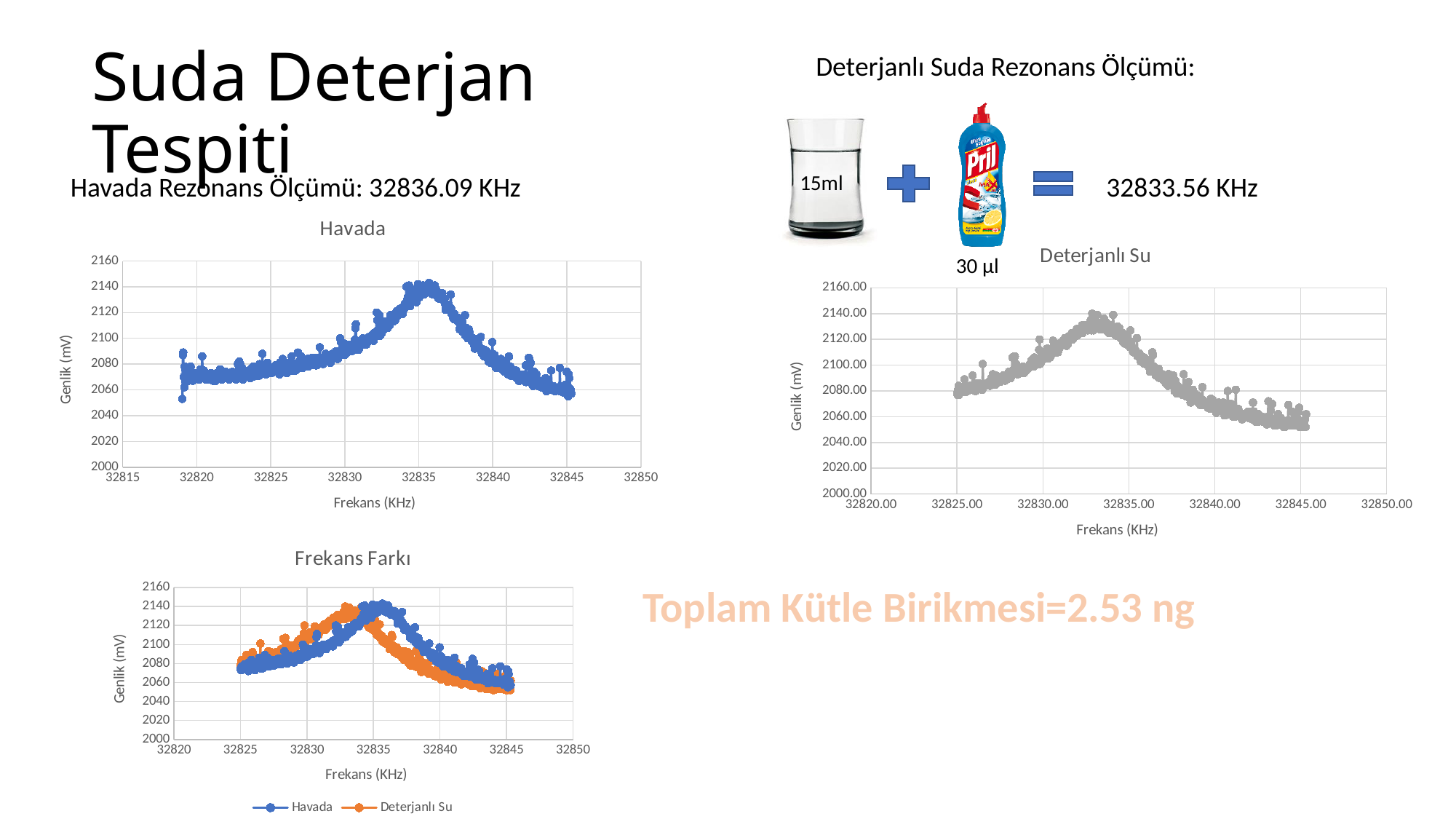
In the "Frekans Farkı" chart, how many series does the legend list? 2 How many charts are shown on the slide? 3 In the "Frekans Farkı" chart, which series reaches its peak at a higher frequency, "Havada" or "Deterjanlı Su"? Havada In the "Frekans Farkı" chart, what are the two series named in the legend? Havada and Deterjanlı Su In the "Deterjanlı Su" chart, is the peak amplitude value greater or less than 2120.00? greater What kind of chart is the "Havada" chart? scatter chart In the "Deterjanlı Su" chart, is the value at 32825.00 KHz greater or less than 2100.00? less In the "Havada" chart, do the values rise or fall between 32835 and 32845 KHz? fall In the "Frekans Farkı" chart, is the "Deterjanlı Su" value at 32840 KHz greater or less than 2080? less In the "Frekans Farkı" chart, what colour is the "Deterjanlı Su" series? orange